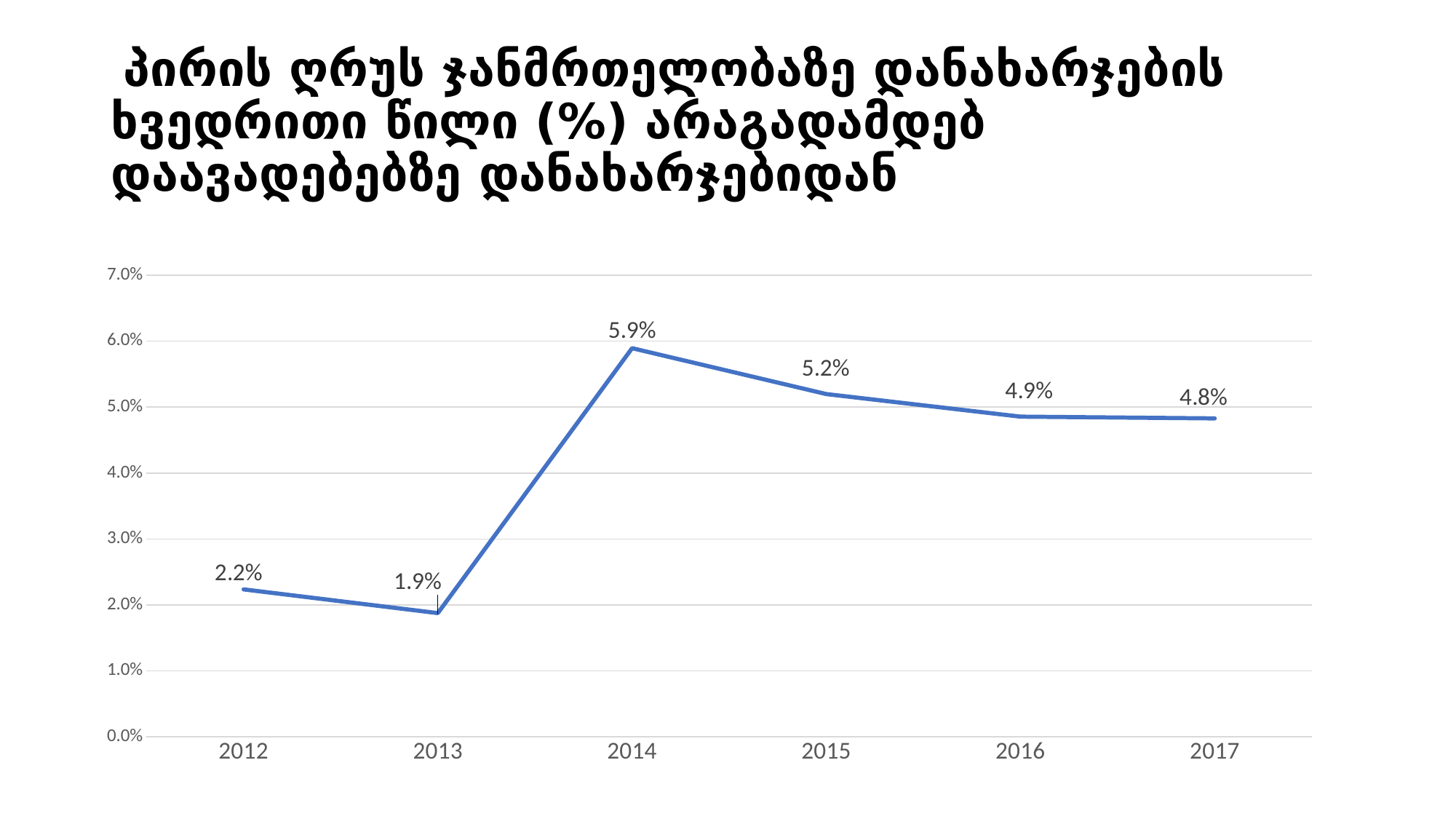
How many years are plotted on the chart? 6 What is the value for 2017? 4.8% What is the value for 2012? 2.2% Is the value for 2016 greater or less than 4.0%? greater What kind of chart is shown on the slide? line chart Does the value rise or fall from 2014 to 2017? fall What is the value for 2014? 5.9% Which year has the highest value? 2014 What is the difference between the values for 2015 and 2016? 0.3% What is the difference between the values for 2014 and 2013? 4.0% Which year has the lowest value? 2013 Which is larger, the value for 2015 or the value for 2017? 2015